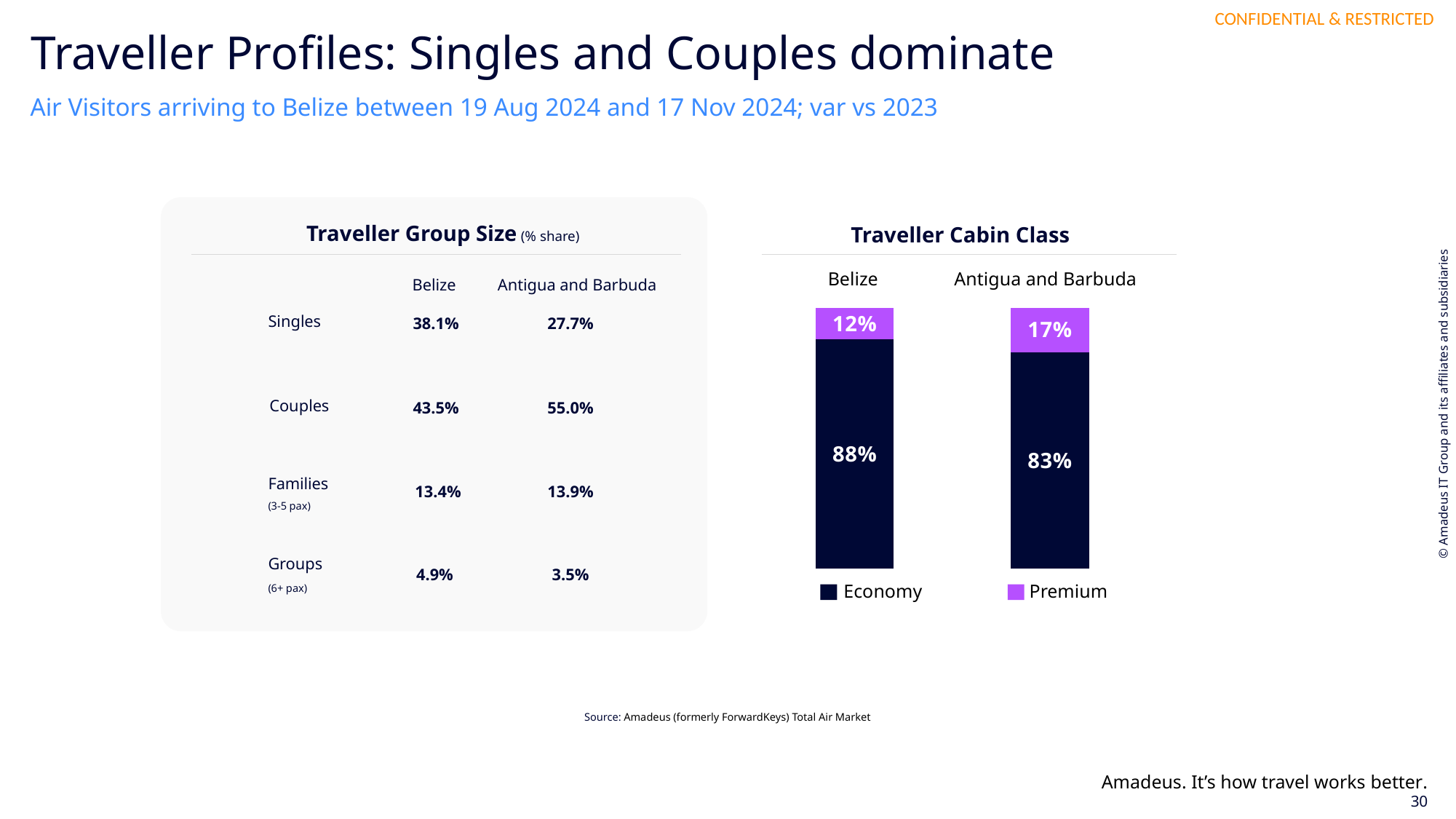
In the Traveller Cabin Class chart, is the Premium share larger for Belize or for Antigua and Barbuda? Antigua and Barbuda How many destinations are shown in the Traveller Cabin Class chart? 2 In the Traveller Cabin Class chart, what is the difference between the Economy shares of Belize and Antigua and Barbuda? 5% How many series does the legend of the Traveller Cabin Class chart list? 2 In the Traveller Cabin Class chart, what is the Premium share for Antigua and Barbuda? 17% In the Traveller Cabin Class chart, what is the Premium share for Belize? 12% In the Traveller Cabin Class chart, what is the Economy share for Antigua and Barbuda? 83% What kind of chart is the Traveller Cabin Class chart? Stacked bar chart In the Traveller Cabin Class chart, what is the Economy share for Belize? 88% In the Traveller Cabin Class chart, what is the total of the Belize stacked bar? 100% In the Traveller Cabin Class chart, which destination has the higher Premium share? Antigua and Barbuda In the Traveller Cabin Class chart, which destination has the lower Economy share? Antigua and Barbuda